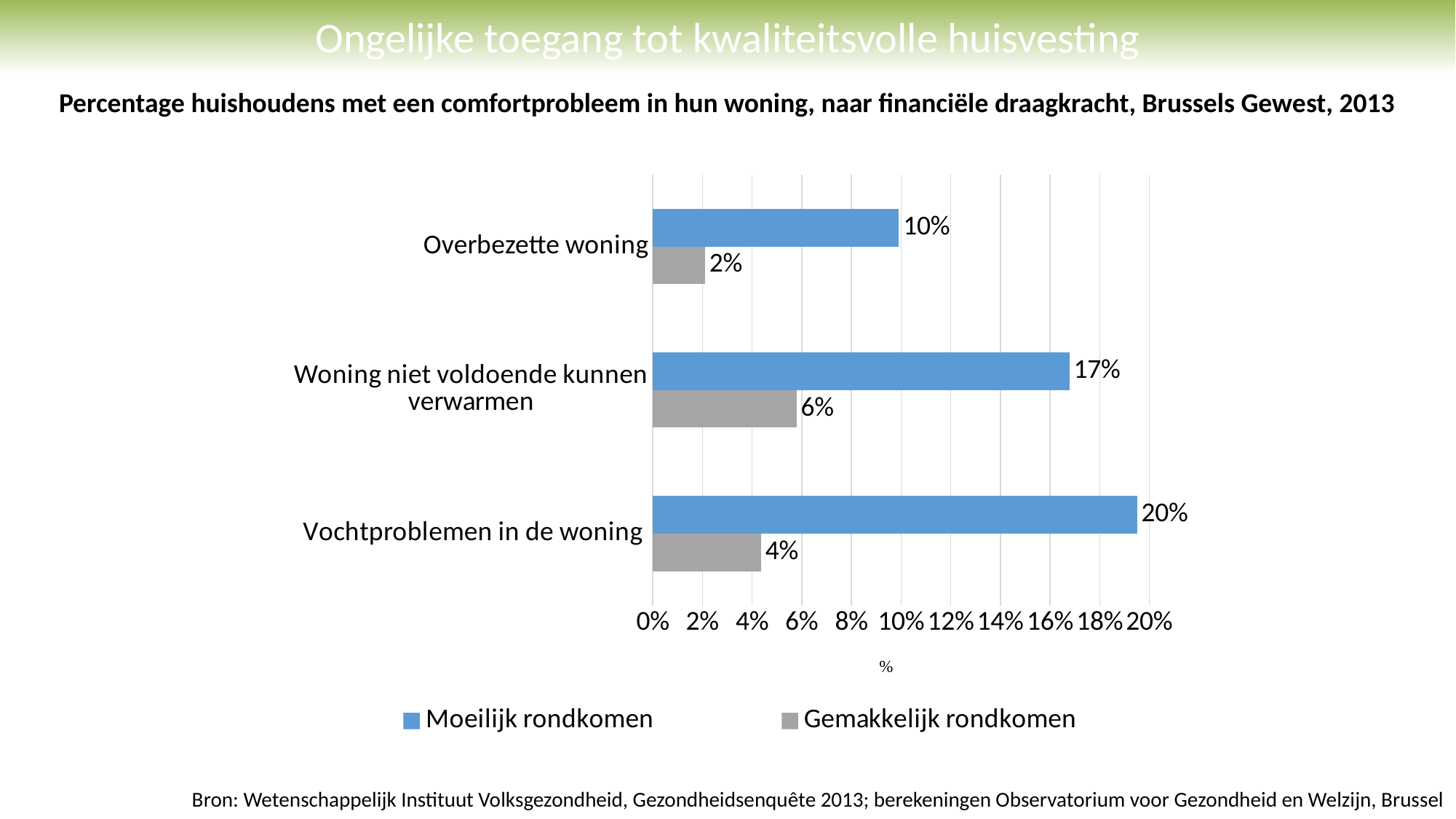
What is the value for 'Gemakkelijk rondkomen' in the 'Woning niet voldoende kunnen verwarmen' category? 6% Which is larger: 'Moeilijk rondkomen' for 'Overbezette woning' or 'Gemakkelijk rondkomen' for 'Woning niet voldoende kunnen verwarmen'? Moeilijk rondkomen for Overbezette woning Which category has the highest value for 'Moeilijk rondkomen'? Vochtproblemen in de woning How many series does the legend list? 2 What kind of chart is shown on the slide? Bar chart What is the difference between 'Moeilijk rondkomen' and 'Gemakkelijk rondkomen' for 'Woning niet voldoende kunnen verwarmen'? 11% Which category has the lowest value for 'Gemakkelijk rondkomen'? Overbezette woning How many categories are shown on the chart? 3 What is the difference between 'Moeilijk rondkomen' and 'Gemakkelijk rondkomen' for 'Vochtproblemen in de woning'? 16% What is the value for 'Moeilijk rondkomen' in the 'Overbezette woning' category? 10% What is the value for 'Gemakkelijk rondkomen' in the 'Vochtproblemen in de woning' category? 4% Which colour represents 'Gemakkelijk rondkomen' in the legend? Grey